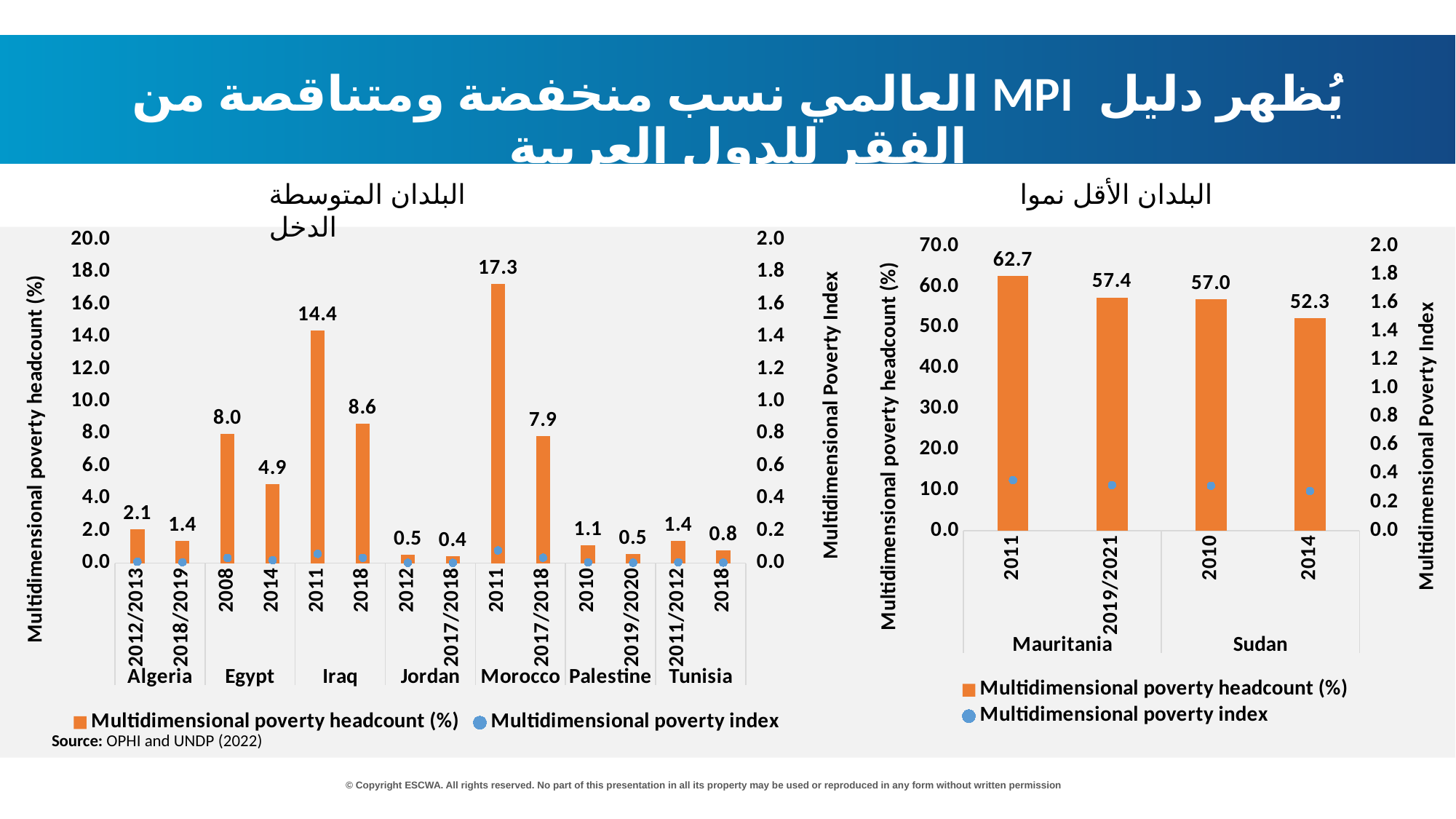
In the left chart, what is the multidimensional poverty headcount (%) for Iraq in 2018? 8.6 In the right chart, which bar has the lowest multidimensional poverty headcount? Sudan 2014 In the left chart, by how much did Egypt's multidimensional poverty headcount (%) fall from 2008 to 2014? 3.1 In the left chart, what is the multidimensional poverty headcount (%) for Morocco in 2011? 17.3 In the left chart, which is larger: the headcount for Iraq in 2011 or for Egypt in 2008? Iraq in 2011 In the left chart, how many countries are shown on the x axis? 7 In the right chart, what is the multidimensional poverty headcount (%) for Sudan in 2014? 52.3 In the right chart, is the multidimensional poverty index for Mauritania in 2011 greater or less than 0.6? less In the right chart, what is the difference between Mauritania's headcount in 2011 and in 2019/2021? 5.3 In the right chart, what is the multidimensional poverty headcount (%) for Mauritania in 2011? 62.7 In the left chart, which country-year bar has the highest multidimensional poverty headcount? Morocco 2011 How many series does the legend of the right chart list? 2